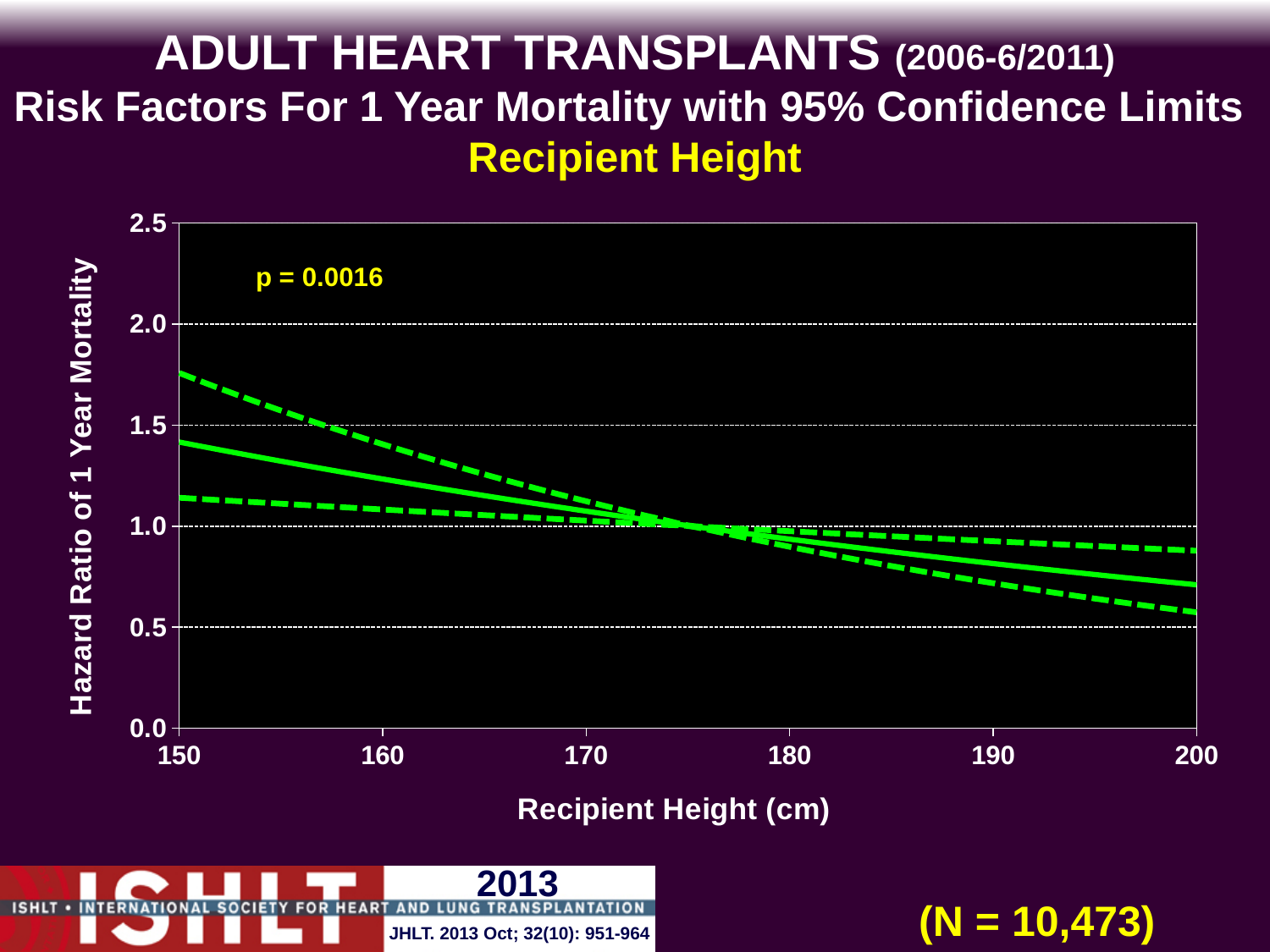
What is the label of the x axis? Recipient Height (cm) Is the upper 95% confidence limit (upper dashed line) at a recipient height of 150 cm greater or less than 1.5? greater Is the hazard ratio (solid line) at a recipient height of 160 cm greater or less than 1.5? less What kind of chart is shown on the slide? Line chart Is the hazard ratio (solid line) at a recipient height of 200 cm greater or less than 1.0? less Does the hazard ratio (solid line) rise or fall as recipient height increases from 150 cm to 200 cm? Fall What is the sample size (N) shown on the slide? N = 10,473 What is the maximum value shown on the y axis? 2.5 How many lines are plotted on the chart? 3 What is the p-value shown on the chart? p = 0.0016